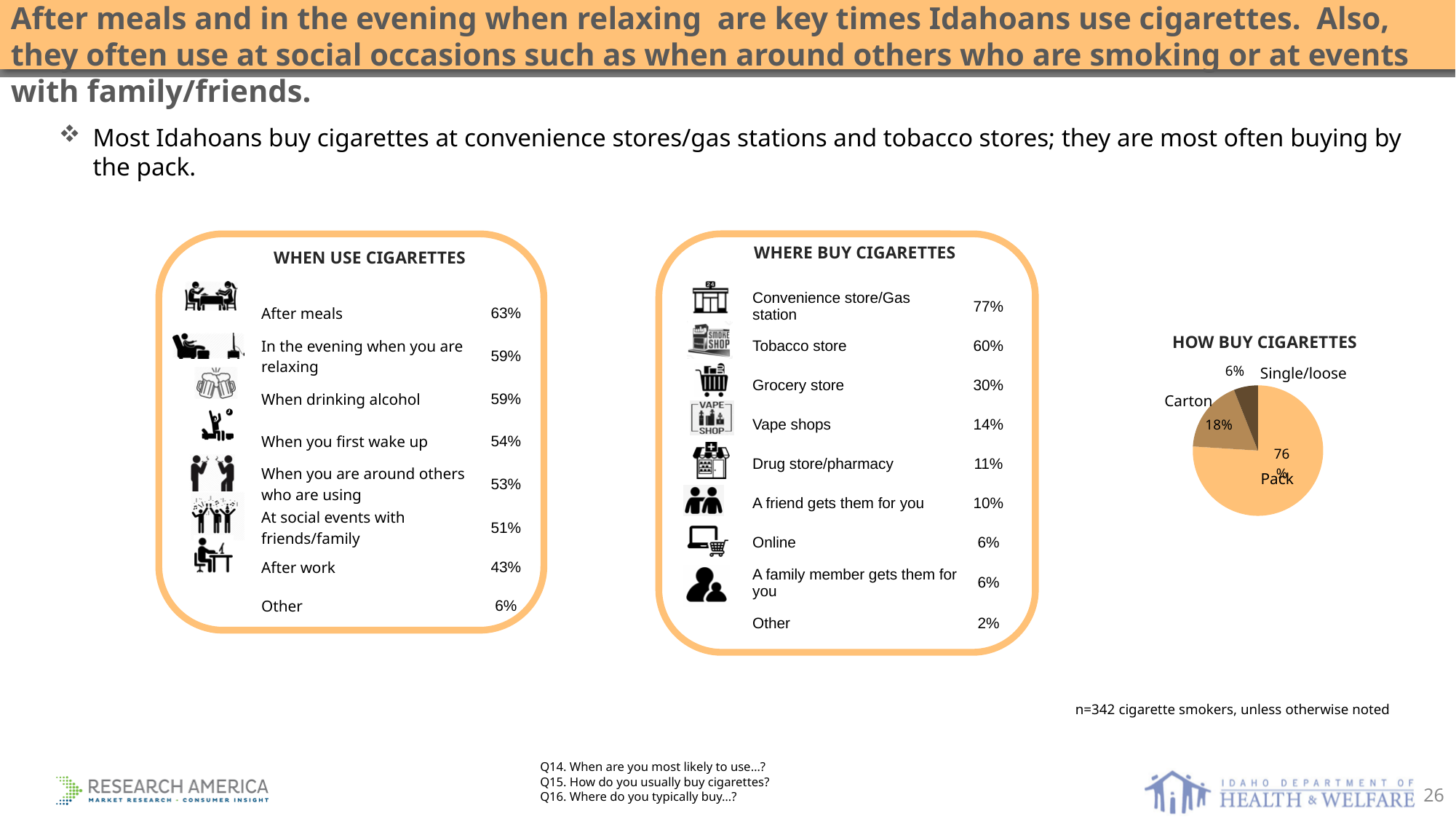
In the "HOW BUY CIGARETTES" pie chart, which category has the smallest slice? Single/loose In the "HOW BUY CIGARETTES" pie chart, what share of the pie does Carton represent? 18% In the "HOW BUY CIGARETTES" pie chart, which is larger, Carton or Single/loose? Carton What is the title of the pie chart on the slide? HOW BUY CIGARETTES In the "HOW BUY CIGARETTES" pie chart, what is the difference in percentage points between Carton and Single/loose? 12 In the "HOW BUY CIGARETTES" pie chart, what percentage is shown for Single/loose? 6% In the "HOW BUY CIGARETTES" pie chart, what percentage is shown for Carton? 18% In the "HOW BUY CIGARETTES" pie chart, what percentage is shown for Pack? 76% What kind of chart is the "HOW BUY CIGARETTES" chart? pie chart In the "HOW BUY CIGARETTES" pie chart, which category has the largest slice? Pack How many slices does the "HOW BUY CIGARETTES" pie chart have? 3 In the "HOW BUY CIGARETTES" pie chart, what is the difference in percentage points between Pack and Carton? 58